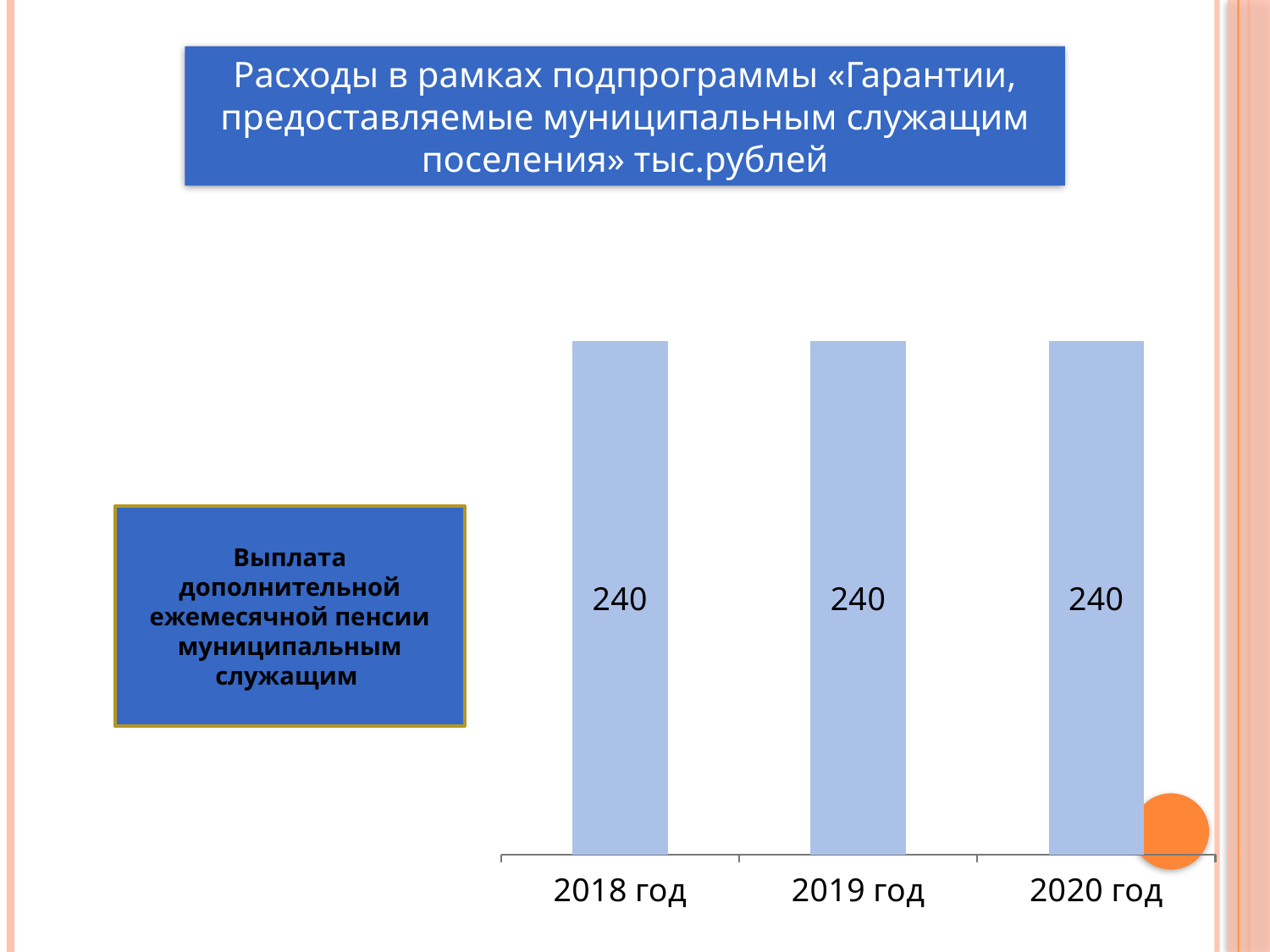
Which years are shown on the x axis of the chart? 2018 год, 2019 год, 2020 год Is the value for 2019 год greater or less than 200? greater How many bars are plotted in the chart? 3 Do the values rise, fall or stay the same from 2018 год to 2020 год? stay the same What is the difference between the values for 2018 год and 2020 год? 0 What is the value for 2020 год? 240 What kind of chart is shown on the slide? bar chart What expense item does the chart show, according to the label box on the left? Выплата дополнительной ежемесячной пенсии муниципальным служащим What is the value for 2018 год? 240 What is the value for 2019 год? 240